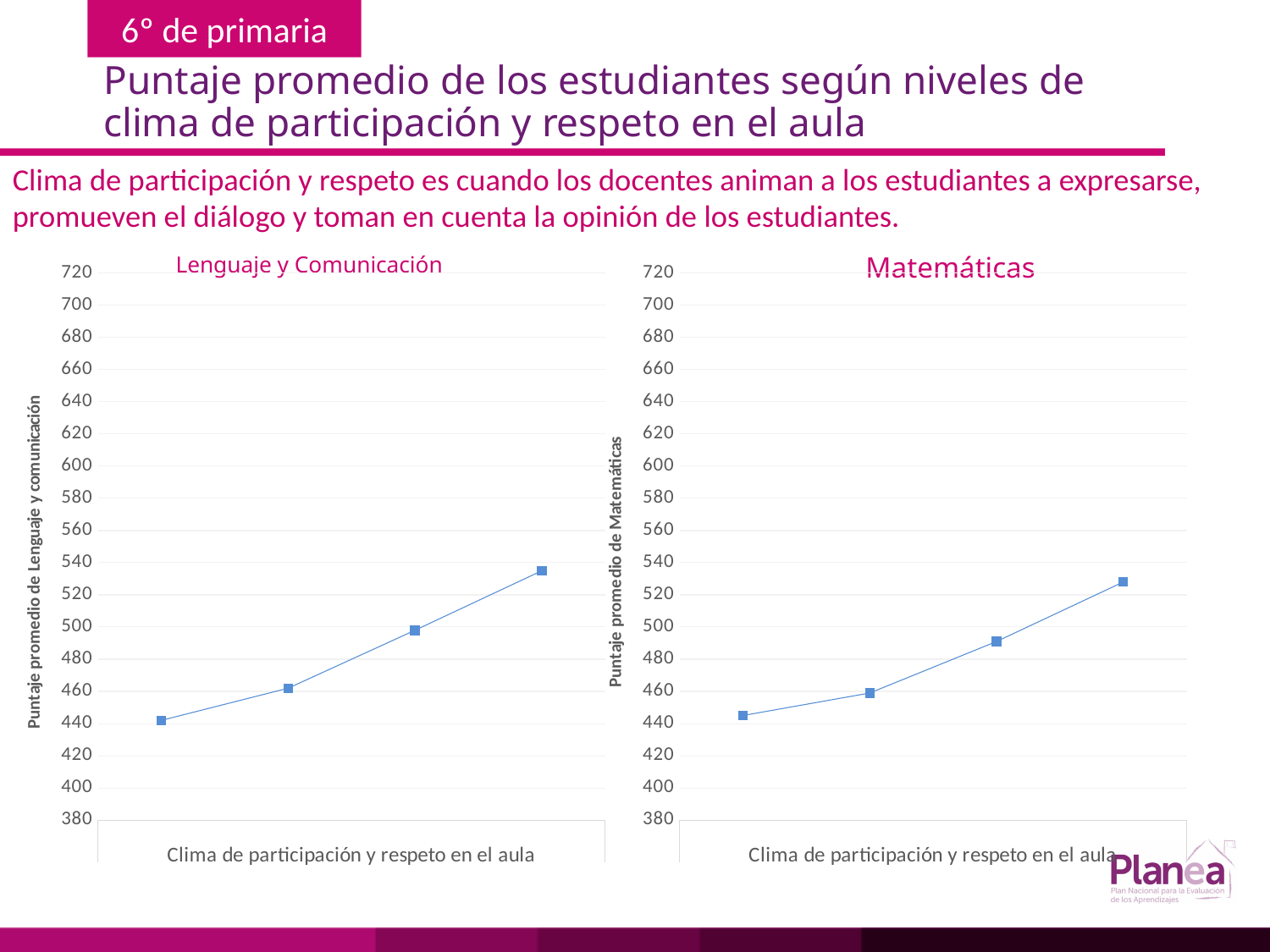
In the Matemáticas chart, is the value of the last (rightmost) point greater or less than 500? greater In the Matemáticas chart, do the values rise or fall from left to right along the x axis? rise In the Matemáticas chart, is the value of the first (leftmost) point greater or less than 460? less What is the x-axis label of the Lenguaje y Comunicación chart? Clima de participación y respeto en el aula How many data points are plotted in the Lenguaje y Comunicación chart? 4 In the Lenguaje y Comunicación chart, is the value of the last (rightmost) point greater or less than 520? greater How many data points are plotted in the Matemáticas chart? 4 What is the y-axis label of the Matemáticas chart? Puntaje promedio de Matemáticas In the Lenguaje y Comunicación chart, do the values rise or fall from left to right along the x axis? rise What kind of chart is the Lenguaje y Comunicación chart? line chart What kind of chart is the Matemáticas chart? line chart